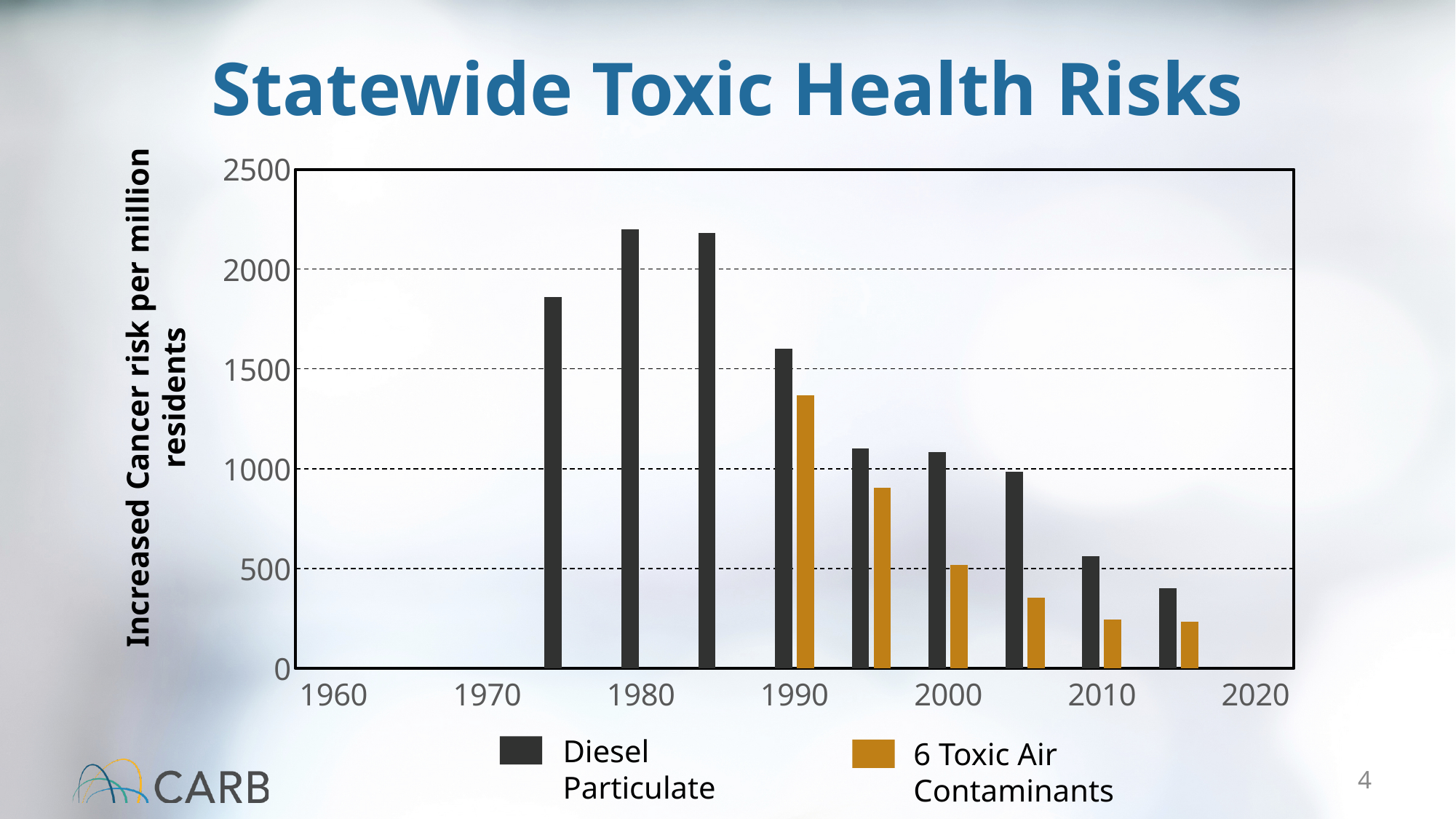
What is the label on the vertical axis? Increased Cancer risk per million residents How many series does the legend list? 2 Is the 6 Toxic Air Contaminants value at 1990 greater or less than 1500? less Is the Diesel Particulate value at 2015 greater or less than 500? less Do the 6 Toxic Air Contaminants values rise or fall from 1990 to 2015? fall At 1990, which series has the larger value, Diesel Particulate or 6 Toxic Air Contaminants? Diesel Particulate What are the two series named in the legend? Diesel Particulate and 6 Toxic Air Contaminants How many Diesel Particulate bars are plotted? 9 Is the 6 Toxic Air Contaminants value at 2005 greater or less than 500? less What kind of chart is shown on the slide? bar chart How many 6 Toxic Air Contaminants bars are plotted? 6